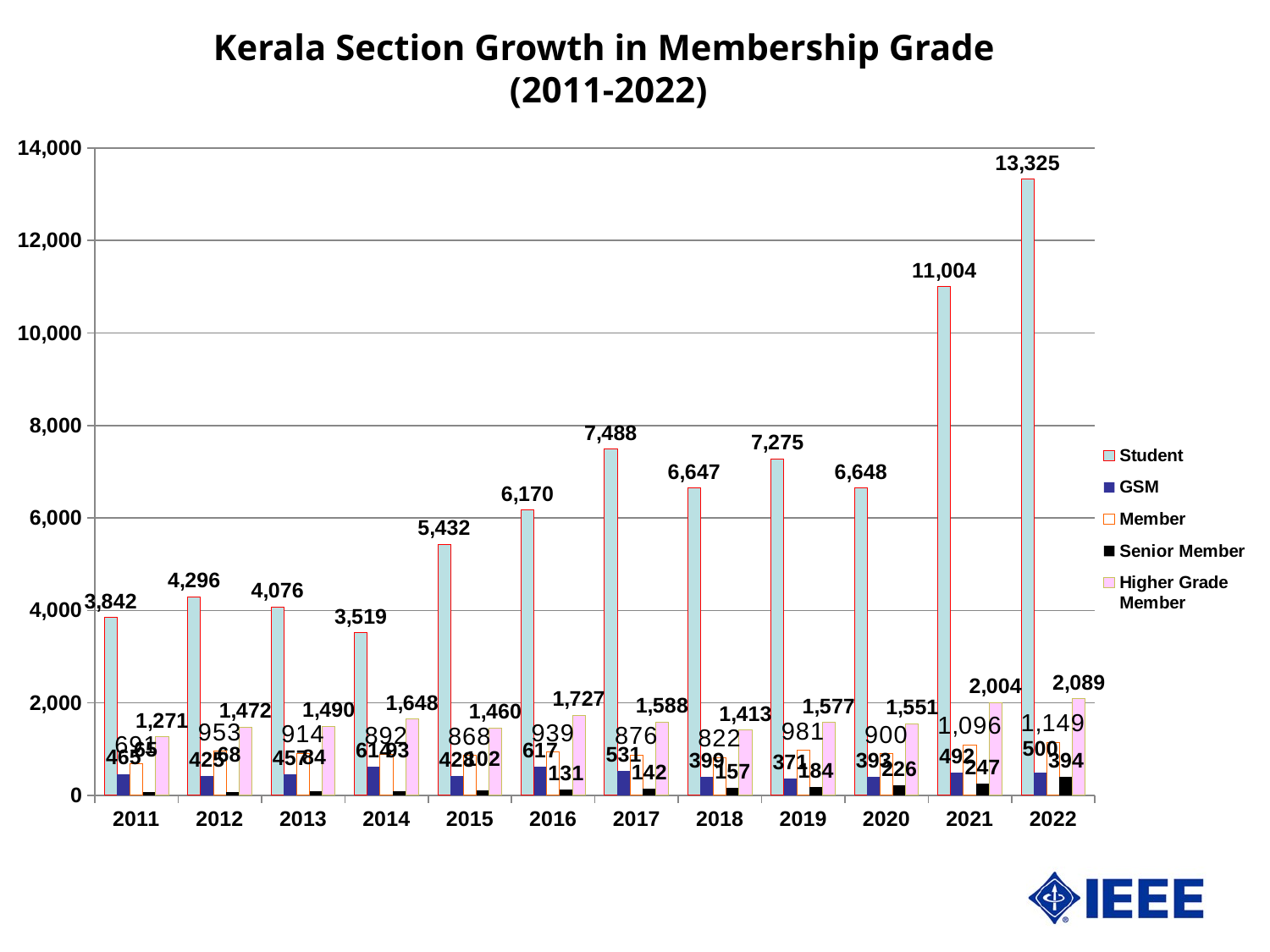
What is the Higher Grade Member value for 2022? 2,089 What is the Senior Member value for 2022? 394 What is the difference between the Student values for 2022 and 2021? 2,321 In which year is the Student value highest? 2022 How many years are shown on the x axis? 12 In which year is the Student value lowest? 2014 What is the Student value for 2022? 13,325 What is the Member value for 2021? 1,096 Which year has the larger Student value, 2017 or 2019? 2017 How many series does the legend list? 5 What kind of chart is shown on the slide? Bar chart Is the Student value for 2021 greater or less than 10,000? greater